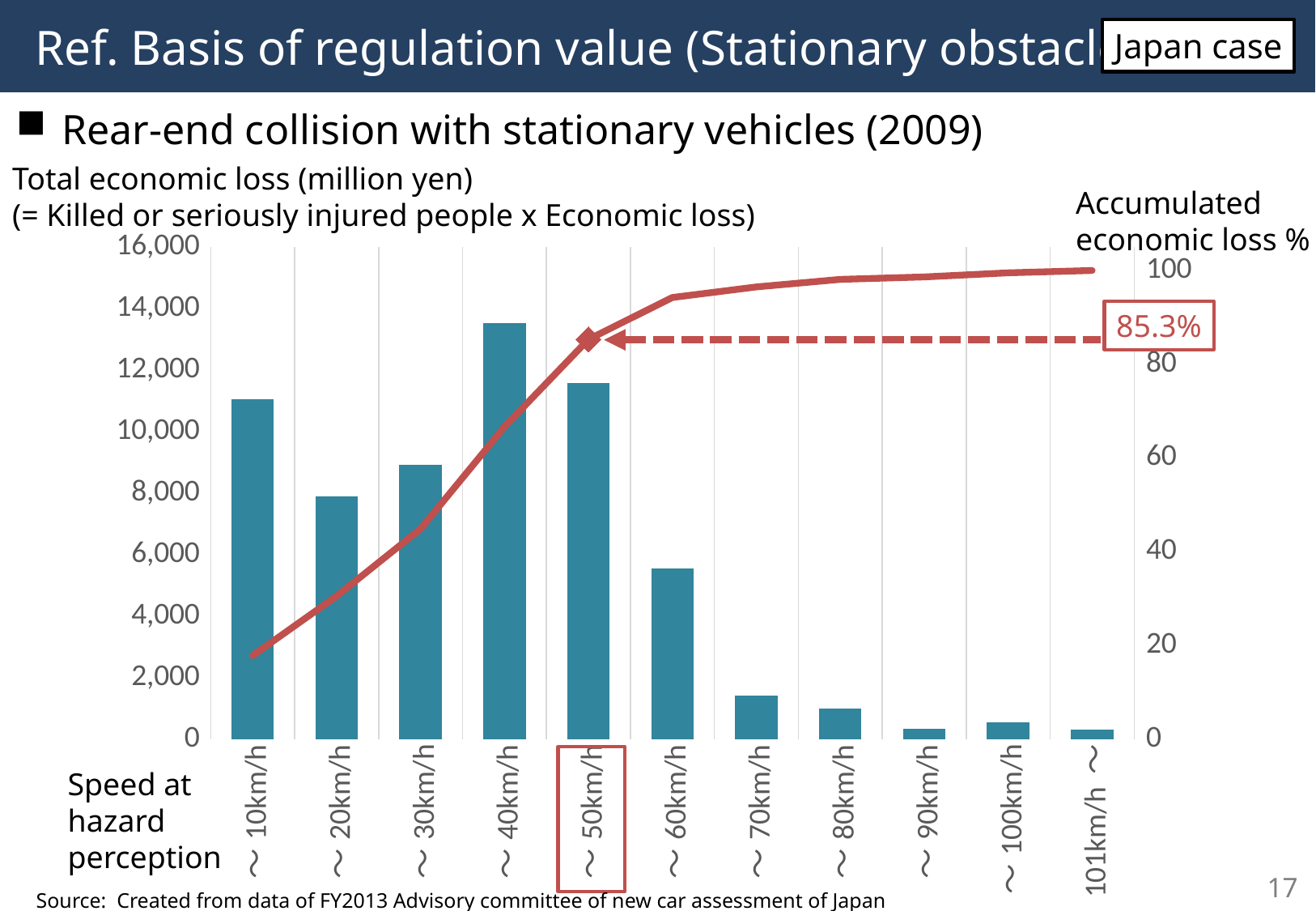
What does the right-hand axis of the chart measure? Accumulated economic loss % Is the total economic loss for ~40km/h greater or less than 12,000? greater Does the accumulated economic loss % line rise or fall as speed increases along the x axis? rise Which has the larger total economic loss, ~60km/h or ~70km/h? ~60km/h Which speed category has the highest total economic loss bar? ~40km/h What kind of chart is used to show total economic loss by speed category? bar chart (with an accumulated percentage line) Is the total economic loss for ~60km/h greater or less than 6,000? less Is the total economic loss for ~10km/h greater or less than 10,000? greater Which has the larger total economic loss, ~40km/h or ~50km/h? ~40km/h How many speed categories are shown on the x axis? 11 What accumulated economic loss percentage is labelled at the ~50km/h speed category? 85.3%